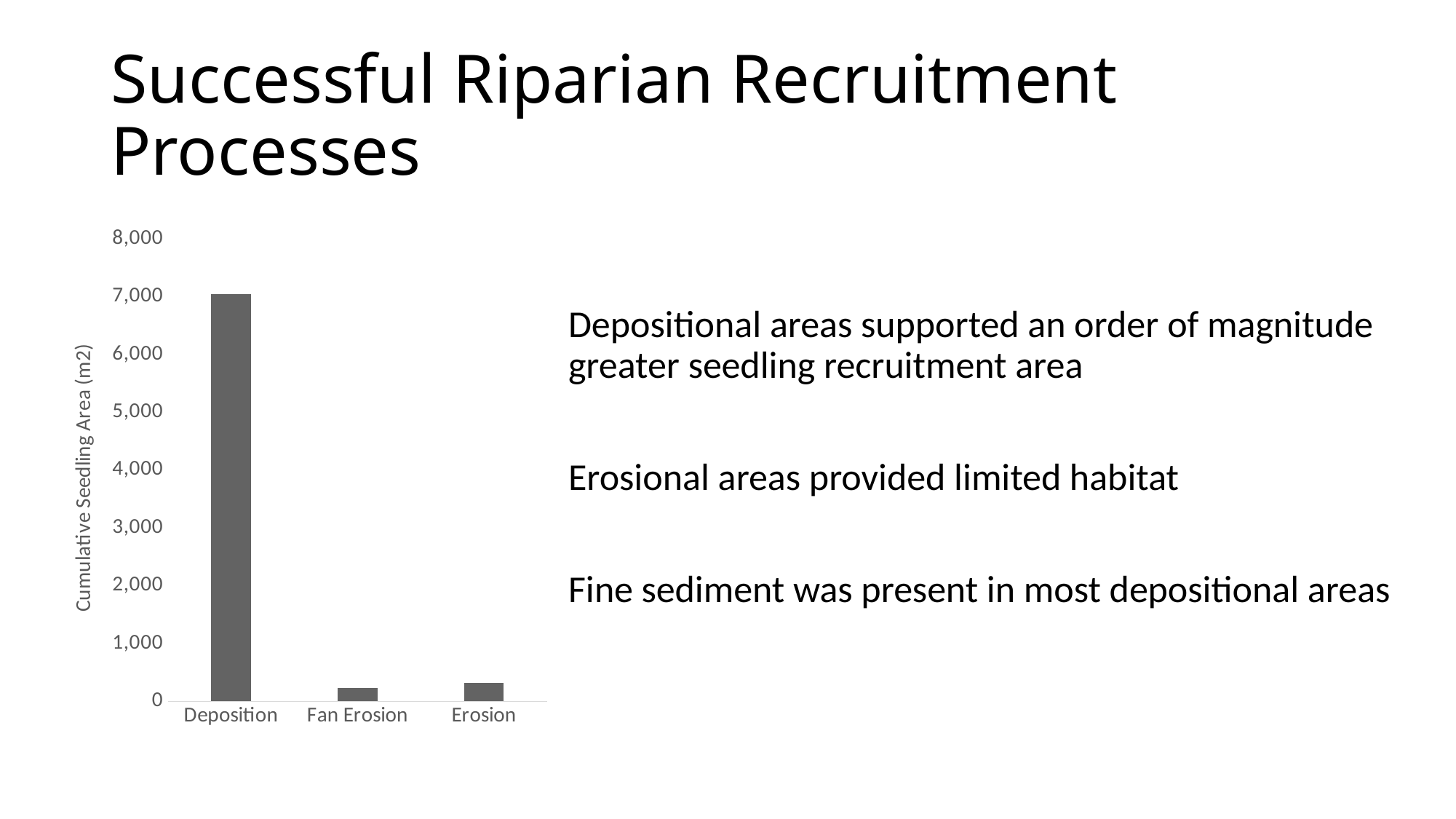
Is the value for Deposition greater or less than 6,000? greater Is the value for Erosion greater or less than 1,000? less How many categories are plotted on the chart? 3 Is the value for Fan Erosion greater or less than 1,000? less What is the title of the vertical axis of the chart? Cumulative Seedling Area (m2) What is the label of the leftmost bar on the chart? Deposition What kind of chart is shown on the slide? bar chart Which is larger, the value for Deposition or the value for Erosion? Deposition Which is larger, the value for Erosion or the value for Fan Erosion? Erosion Which category has the lowest cumulative seedling area? Fan Erosion Which category has the highest cumulative seedling area? Deposition